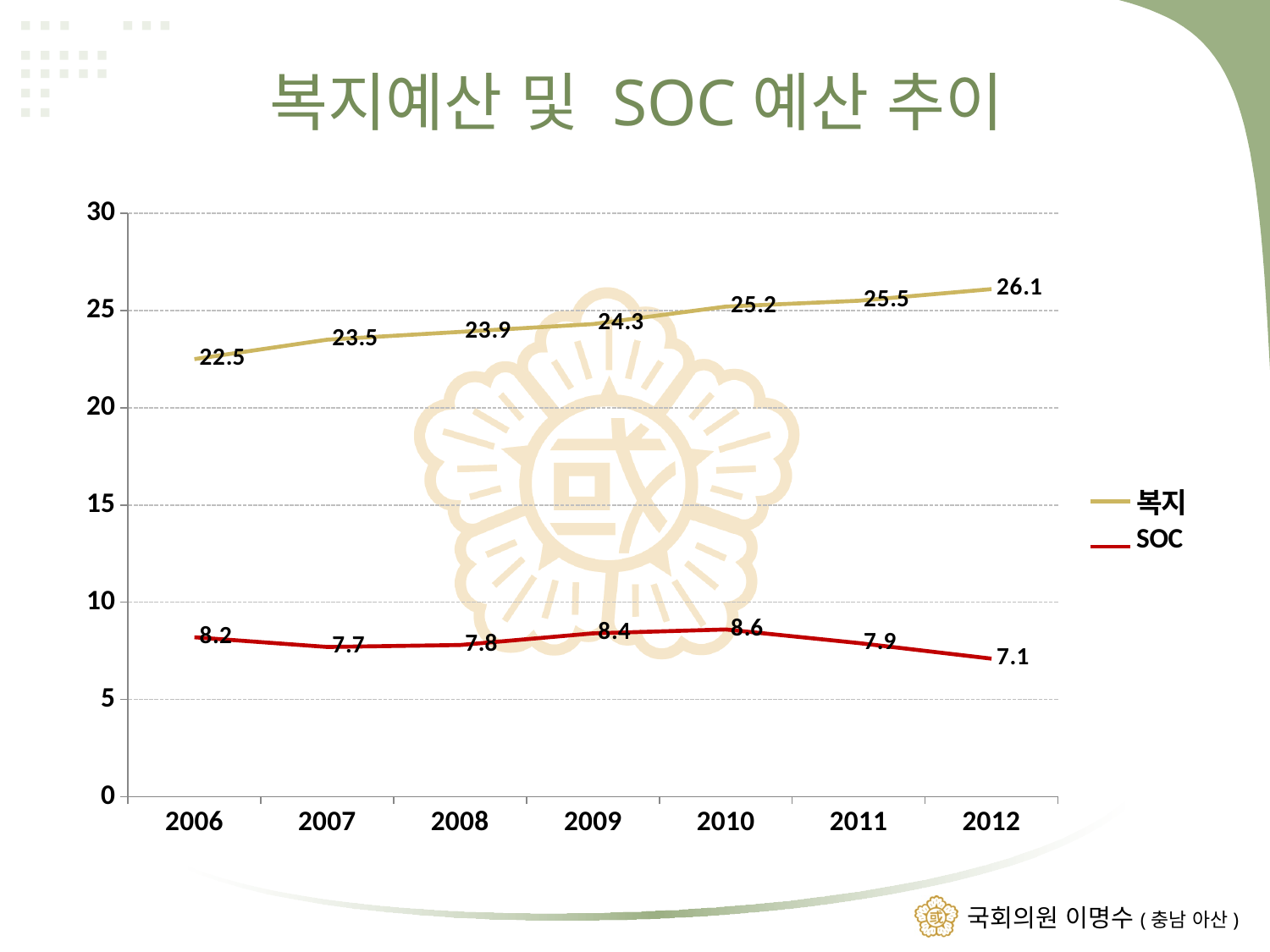
In which year is the SOC value lowest? 2012 What is the value for 복지 in 2006? 22.5 Does the 복지 series rise or fall from 2006 to 2012? rise How many years are shown on the x axis? 7 Is the SOC value in 2011 greater or less than 10? less What is the value for 복지 in 2012? 26.1 How many series does the legend list? 2 What is the difference between the 복지 value and the SOC value in 2012? 19 Which is larger in 2009, the 복지 value or the SOC value? 복지 In which year is the 복지 value highest? 2012 What is the value for SOC in 2010? 8.6 What kind of chart is shown on the slide? line chart